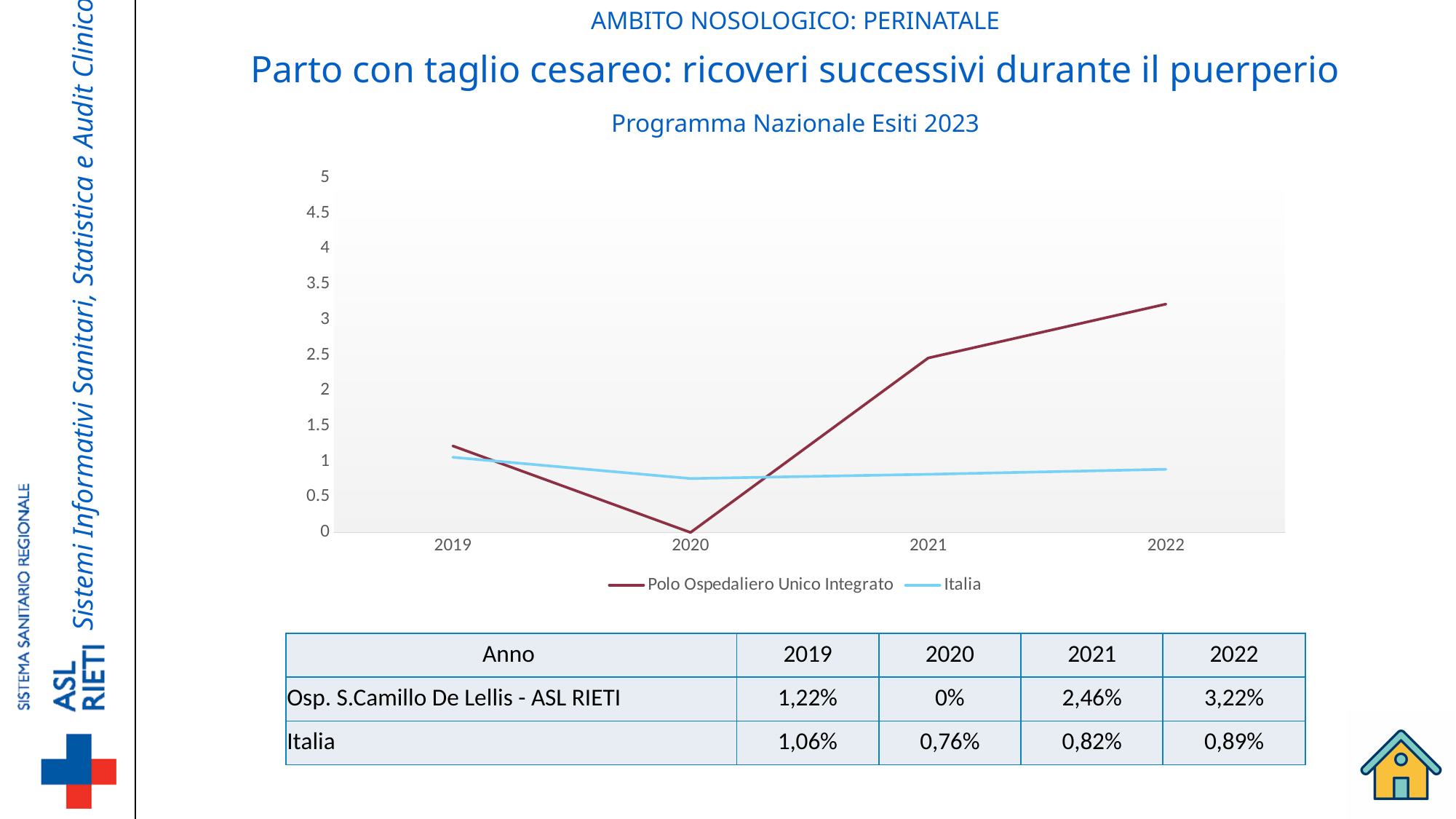
In which year does the Polo Ospedaliero Unico Integrato line reach its highest value? 2022 Which series has the higher value in 2021, Polo Ospedaliero Unico Integrato or Italia? Polo Ospedaliero Unico Integrato According to the table below the chart, what is the value for Osp. S.Camillo De Lellis - ASL RIETI in 2020? 0% How many series does the chart legend list? 2 What kind of chart is shown on the slide? line chart How many years are plotted along the x axis of the chart? 4 Is the value for Polo Ospedaliero Unico Integrato in 2022 greater or less than 3? greater According to the table below the chart, what is the value for Osp. S.Camillo De Lellis - ASL RIETI in 2022? 3,22% In which year does the Polo Ospedaliero Unico Integrato line reach its lowest value? 2020 According to the table below the chart, what is the value for Italia in 2020? 0,76% Using the table values, what is the difference between Osp. S.Camillo De Lellis - ASL RIETI and Italia in 2022? 2,33% Does the Polo Ospedaliero Unico Integrato line rise or fall from 2020 to 2022? rise